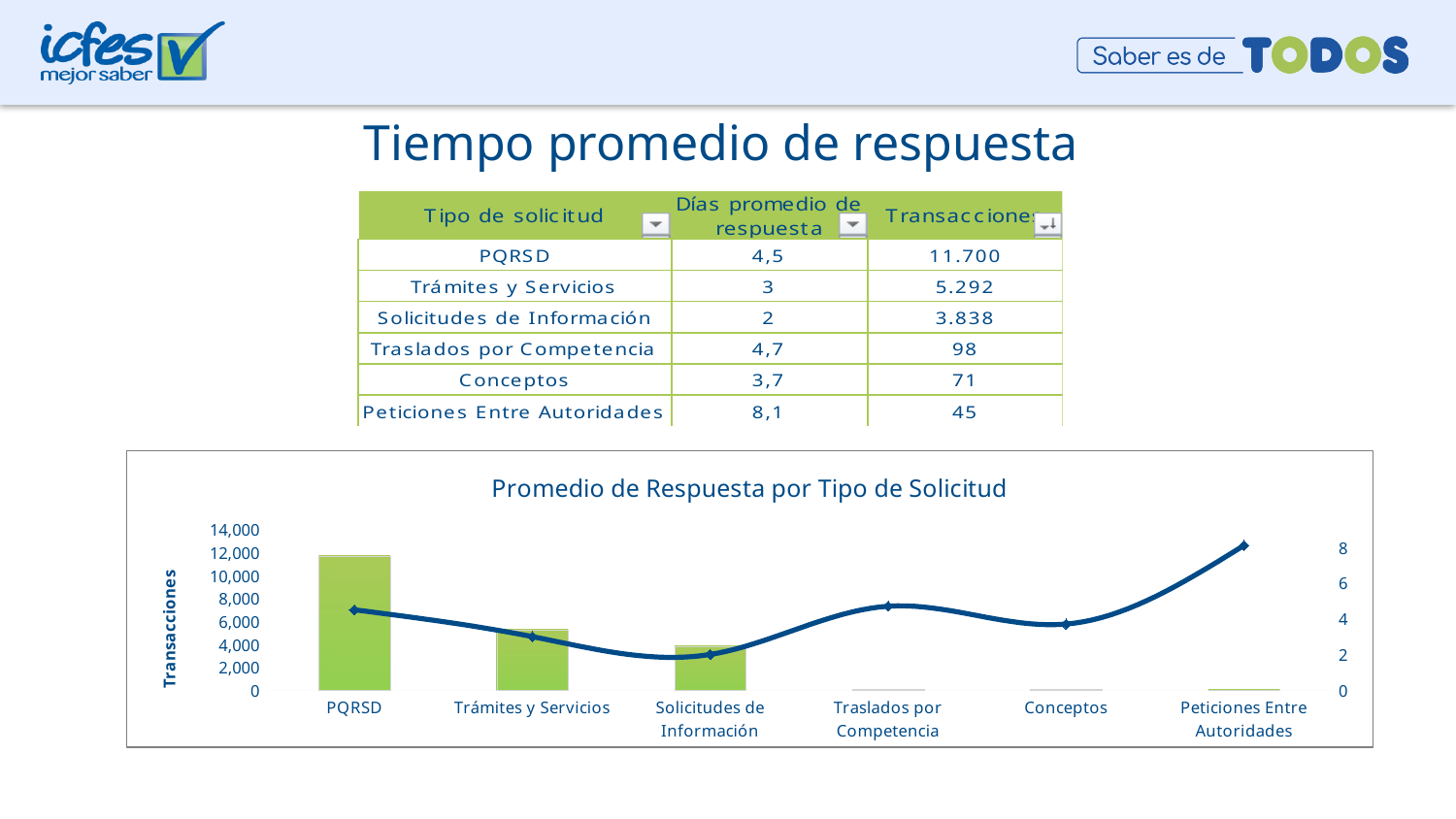
Is the line value for Peticiones Entre Autoridades on the right axis greater or less than 6? greater Is the bar value for PQRSD greater or less than 10,000? greater Which category has the lowest point on the line in the chart? Solicitudes de Información Does the line rise or fall from Solicitudes de Información to Peticiones Entre Autoridades? rises Is the line value for PQRSD on the right axis greater or less than 6? less What is the title of the chart? Promedio de Respuesta por Tipo de Solicitud Which has the taller bar, PQRSD or Trámites y Servicios? PQRSD How many categories are shown on the x axis of the chart? 6 What kind of chart is shown on the slide? A bar chart combined with a line Which category has the highest point on the line in the chart? Peticiones Entre Autoridades Which category has the tallest bar in the chart? PQRSD